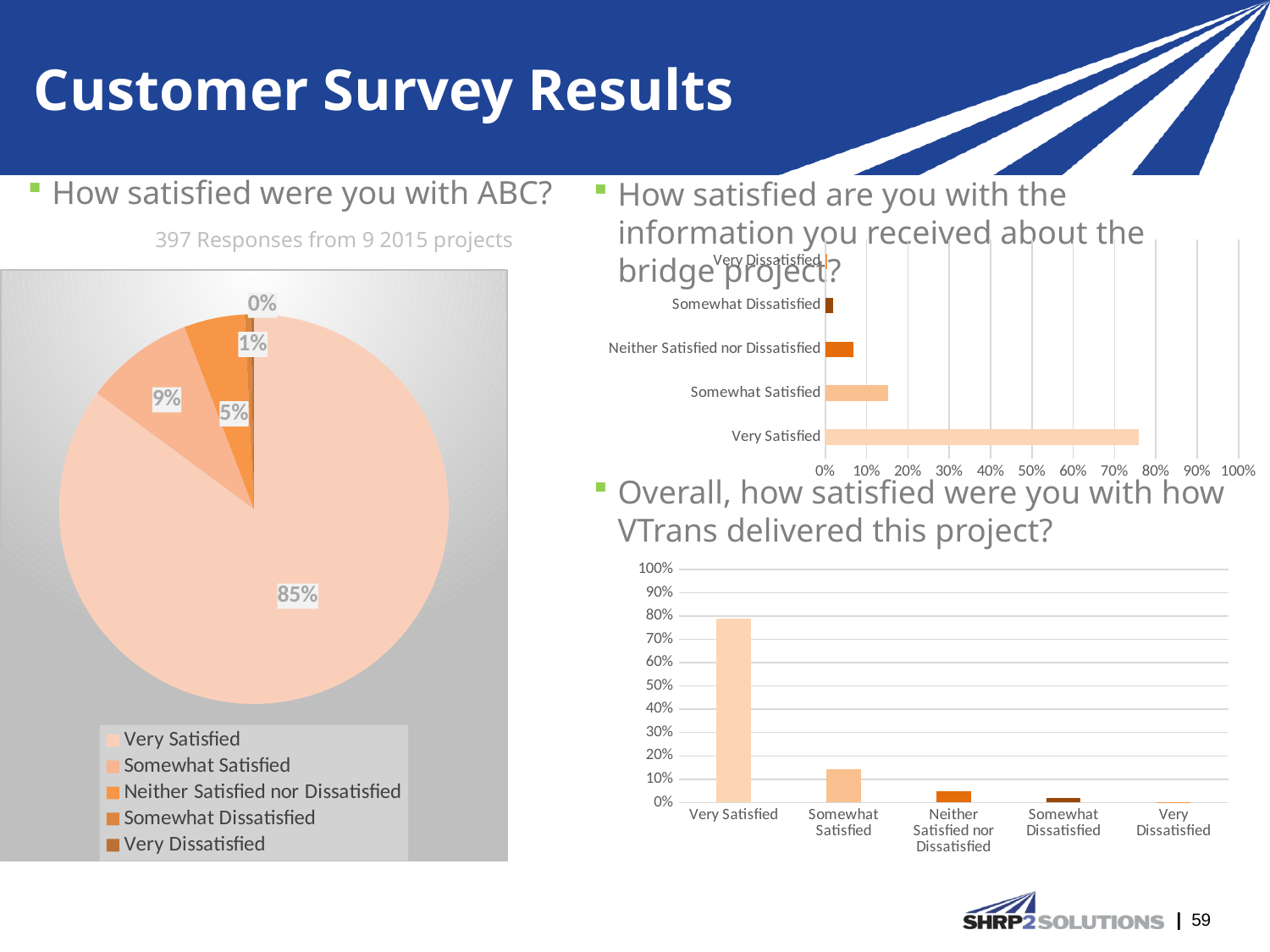
How many categories does the legend of the pie chart 'How satisfied were you with ABC?' list? 5 On the chart 'Overall, how satisfied were you with how VTrans delivered this project?', is the value for Somewhat Satisfied greater or less than 20%? less On the pie chart 'How satisfied were you with ABC?', what percentage of respondents were Somewhat Satisfied? 9% On the chart 'How satisfied are you with the information you received about the bridge project?', is the value for Somewhat Satisfied greater or less than 20%? less On the pie chart 'How satisfied were you with ABC?', what is the difference between the Very Satisfied and Somewhat Satisfied shares? 76% On the chart 'How satisfied are you with the information you received about the bridge project?', is the value for Very Satisfied greater or less than 70%? greater What type of chart is used for 'How satisfied are you with the information you received about the bridge project?' Bar chart On the chart 'Overall, how satisfied were you with how VTrans delivered this project?', which category has the highest bar? Very Satisfied On the pie chart 'How satisfied were you with ABC?', what percentage were Neither Satisfied nor Dissatisfied? 5% On the pie chart 'How satisfied were you with ABC?', which category has the largest slice? Very Satisfied How many responses does the subtitle of the pie chart 'How satisfied were you with ABC?' say were collected? 397 On the pie chart 'How satisfied were you with ABC?', what percentage of respondents were Very Satisfied? 85%